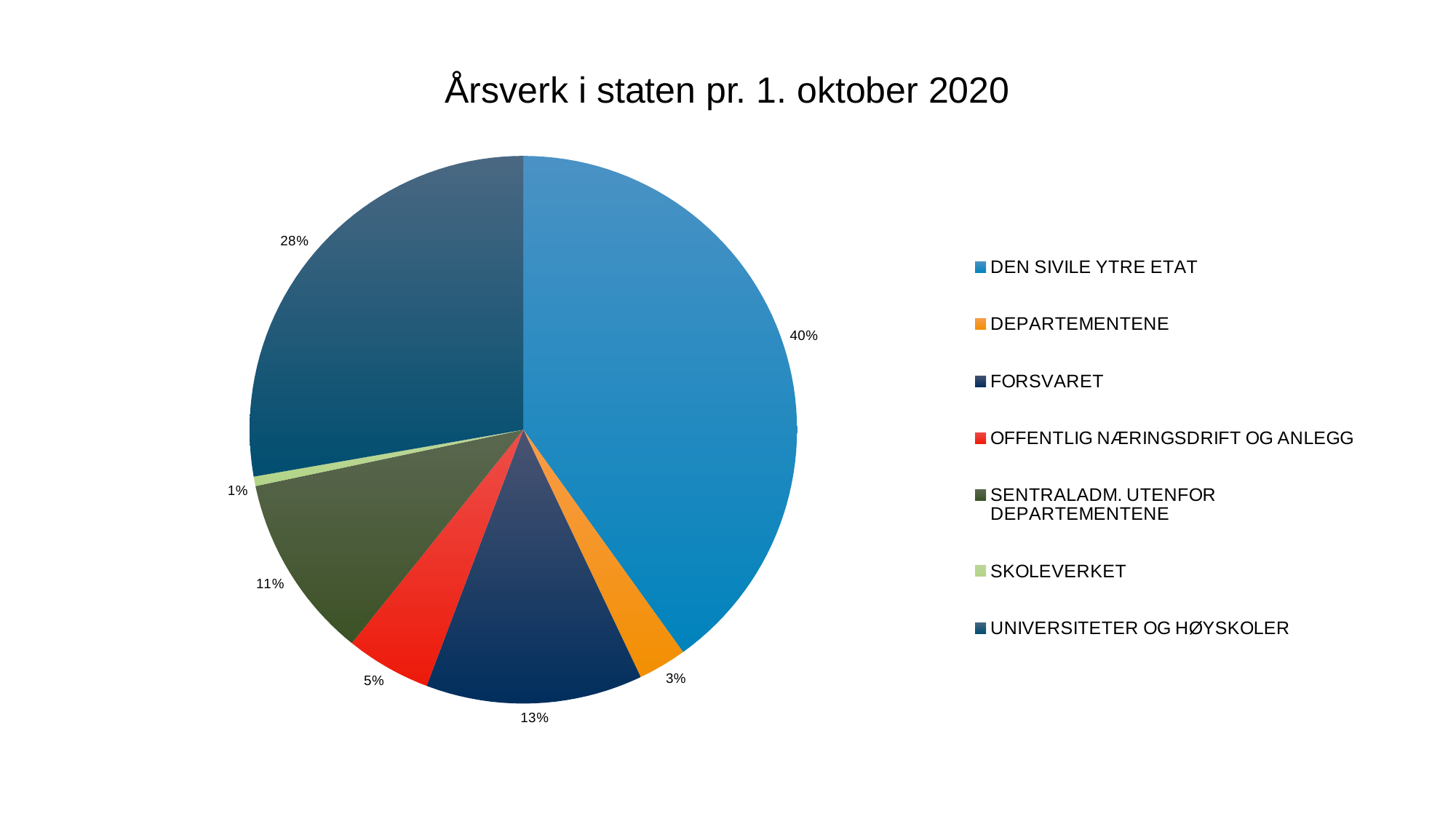
What is the difference in percentage points between DEN SIVILE YTRE ETAT and UNIVERSITETER OG HØYSKOLER? 12 percentage points What share of the pie does FORSVARET represent? 13% Which category has the smallest slice of the pie? SKOLEVERKET Which category has the largest slice of the pie? DEN SIVILE YTRE ETAT How many categories does the pie chart have? 7 What share of the pie does SENTRALADM. UTENFOR DEPARTEMENTENE represent? 11% What share of the pie does UNIVERSITETER OG HØYSKOLER represent? 28% What is the title of the chart? Årsverk i staten pr. 1. oktober 2020 What type of chart is shown on the slide? Pie chart Which is larger, the share for FORSVARET or the share for OFFENTLIG NÆRINGSDRIFT OG ANLEGG? FORSVARET